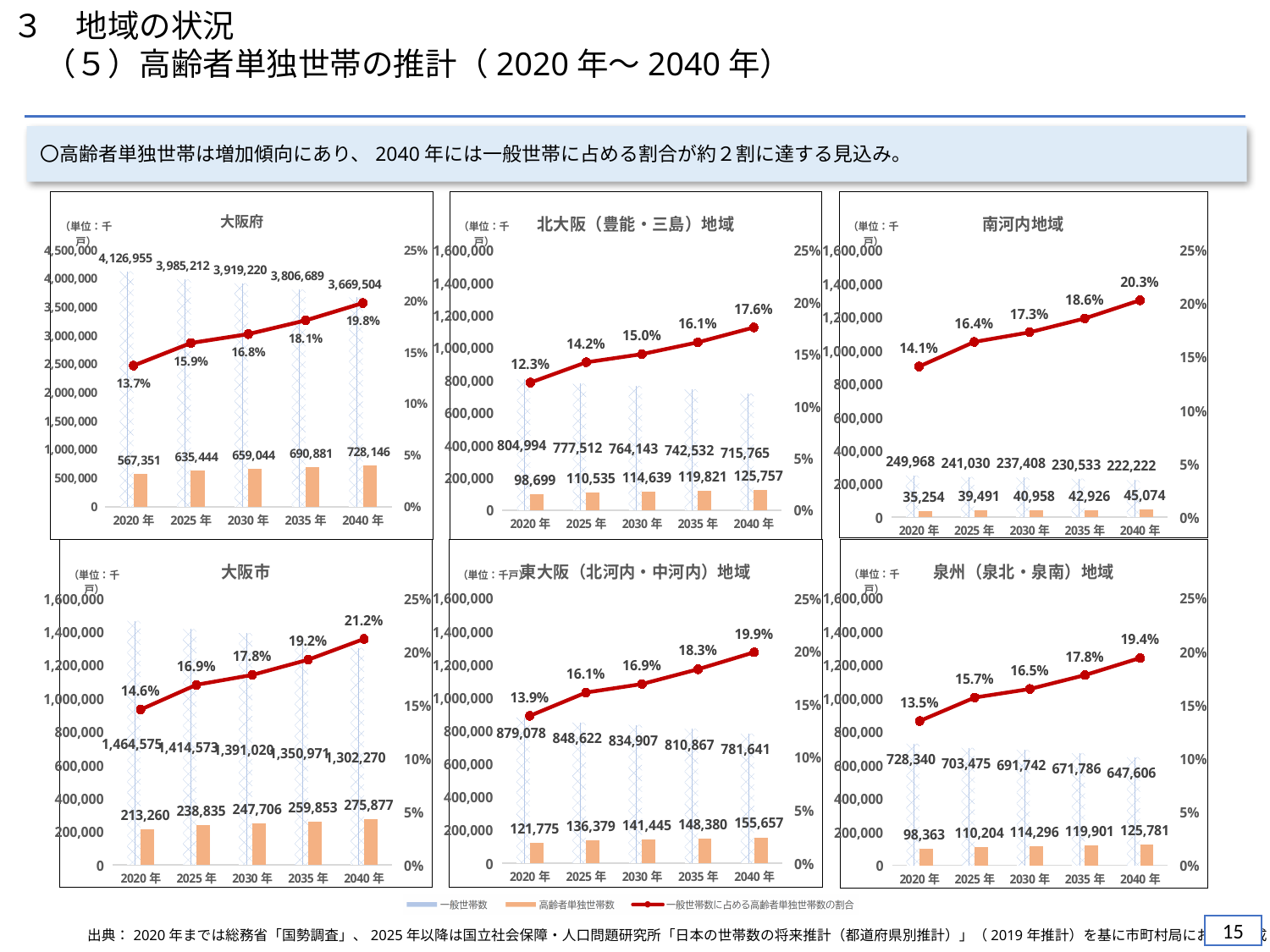
In the 東大阪（北河内・中河内）地域 chart, what is the 一般世帯数 value for 2040年? 781,641 How many years are shown on the x axis of the 南河内地域 chart? 5 In the 南河内地域 chart, which year has the highest 一般世帯数に占める高齢者単独世帯数の割合? 2040年 How many series does the shared legend at the bottom of the slide list? 3 In the 大阪市 chart, what is the difference between the 高齢者単独世帯数 for 2040年 and for 2020年? 62,617 In the 北大阪（豊能・三島）地域 chart, what is the 一般世帯数に占める高齢者単独世帯数の割合 for 2040年? 17.6% In the 大阪府 chart, what is the 高齢者単独世帯数 value for 2040年? 728,146 In the 南河内地域 chart, what is the 高齢者単独世帯数 value for 2020年? 35,254 In the 大阪市 chart, what is the 一般世帯数に占める高齢者単独世帯数の割合 for 2040年? 21.2% In the 大阪府 chart, what is the 一般世帯数 value for 2020年? 4,126,955 In the 泉州（泉北・泉南）地域 chart, what is the 一般世帯数に占める高齢者単独世帯数の割合 for 2020年? 13.5% In the 大阪府 chart, does the 一般世帯数 rise or fall from 2020年 to 2040年? fall